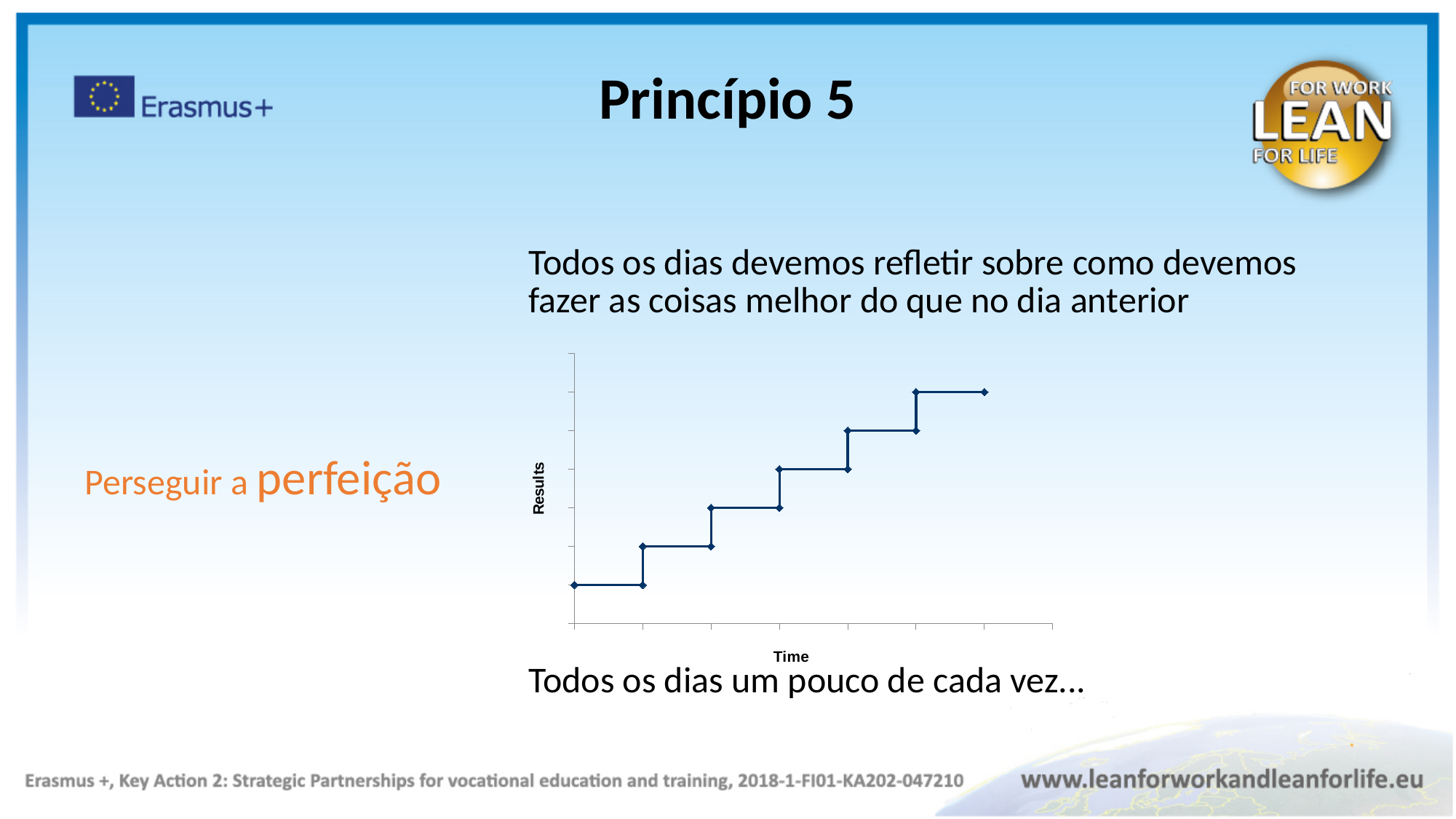
How many lines (series) are plotted in the chart? 1 Do the values in the chart rise or fall along the Time axis? rise What is the label of the horizontal axis of the chart? Time What is the label of the vertical axis of the chart? Results Is the value at the right end of the line higher or lower than the value at the left end? higher What kind of chart is shown on the slide? line chart